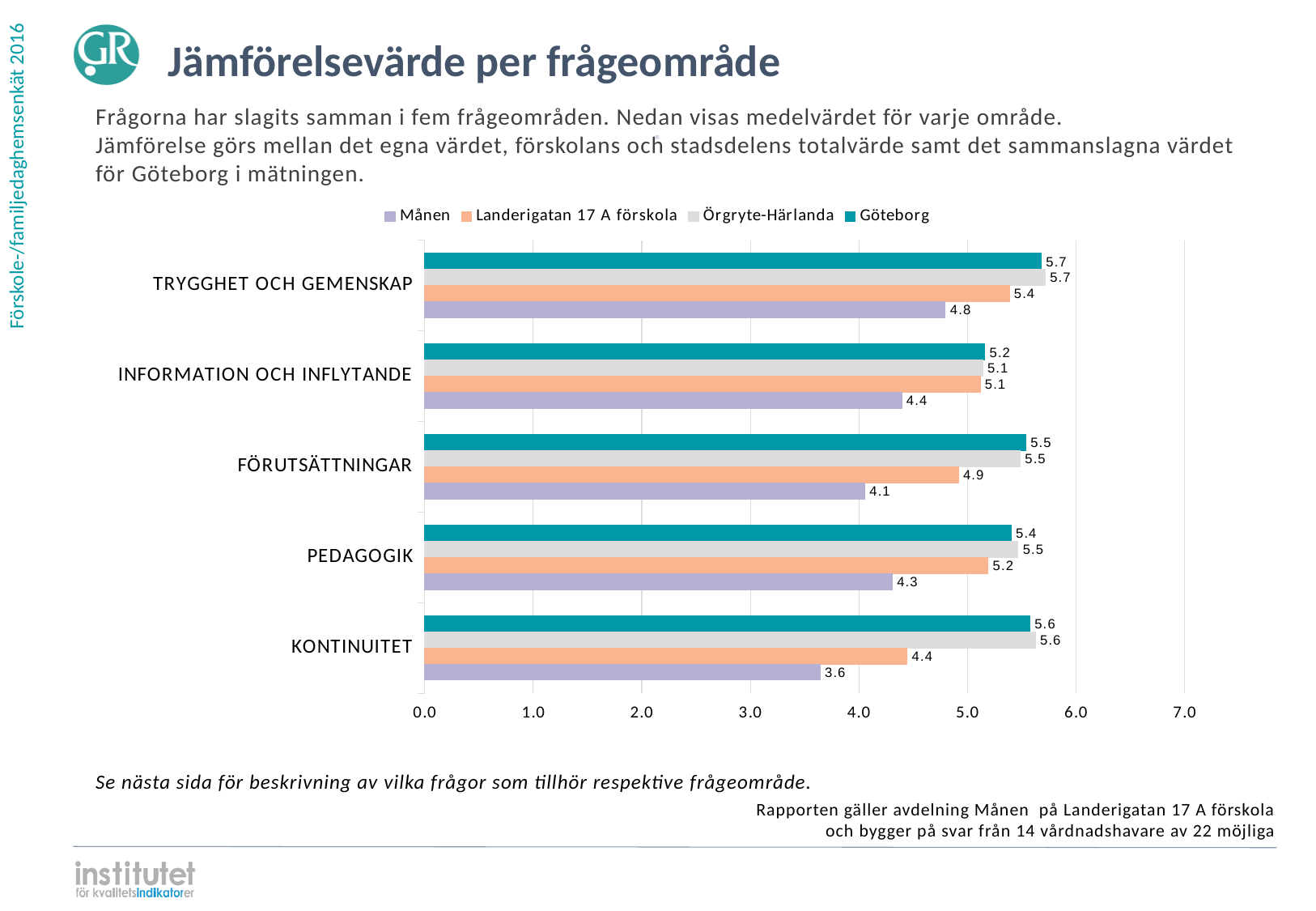
Which is larger in the PEDAGOGIK category: the value for Örgryte-Härlanda or the value for Landerigatan 17 A förskola? Örgryte-Härlanda What is the value for Månen in the KONTINUITET category? 3.6 How many series does the legend list? 4 What is the value for Landerigatan 17 A förskola in the FÖRUTSÄTTNINGAR category? 4.9 How many question areas (categories) are shown on the chart? 5 Which series is shown in teal on the chart? Göteborg Is the value for Månen in FÖRUTSÄTTNINGAR greater or less than 5.0? less In which category does Landerigatan 17 A förskola have its lowest value? KONTINUITET What is the difference between the Göteborg value and the Månen value in the KONTINUITET category? 2.0 In which category does Månen have its highest value? TRYGGHET OCH GEMENSKAP What is the value for Göteborg in the INFORMATION OCH INFLYTANDE category? 5.2 What kind of chart is shown on the slide? Bar chart